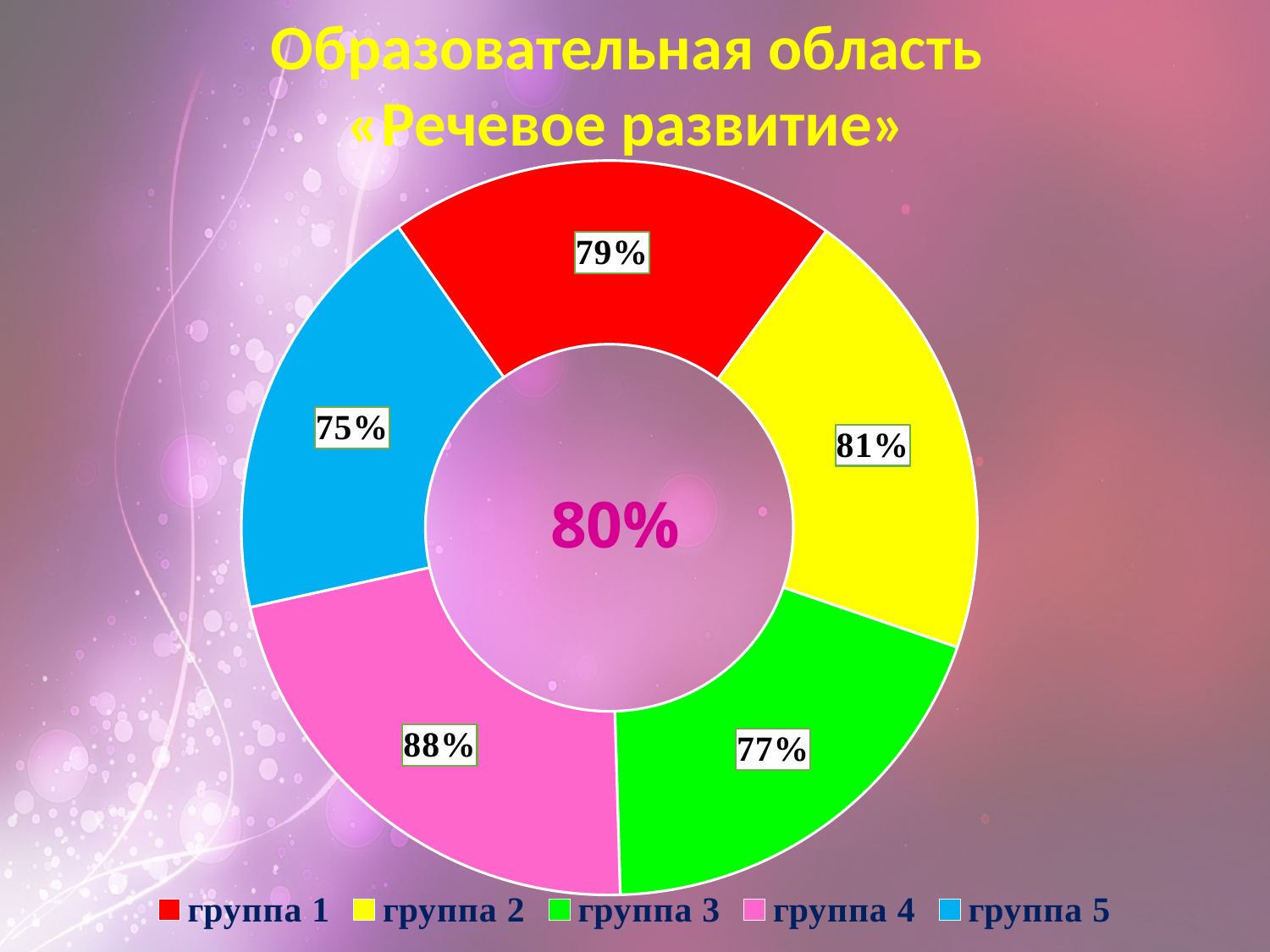
What value is printed in the centre of the chart? 80% Which is larger, the value for группа 2 or the value for группа 3? группа 2 What value is shown for группа 4? 88% What value is shown for группа 2? 81% What value is shown for группа 1? 79% What kind of chart is shown on the slide? doughnut chart What value is shown for группа 5? 75% What value is shown for группа 3? 77% How many groups does the legend list? 5 Which group has the lowest value? группа 5 What is the difference between the values for группа 4 and группа 5? 13% Which group has the highest value? группа 4